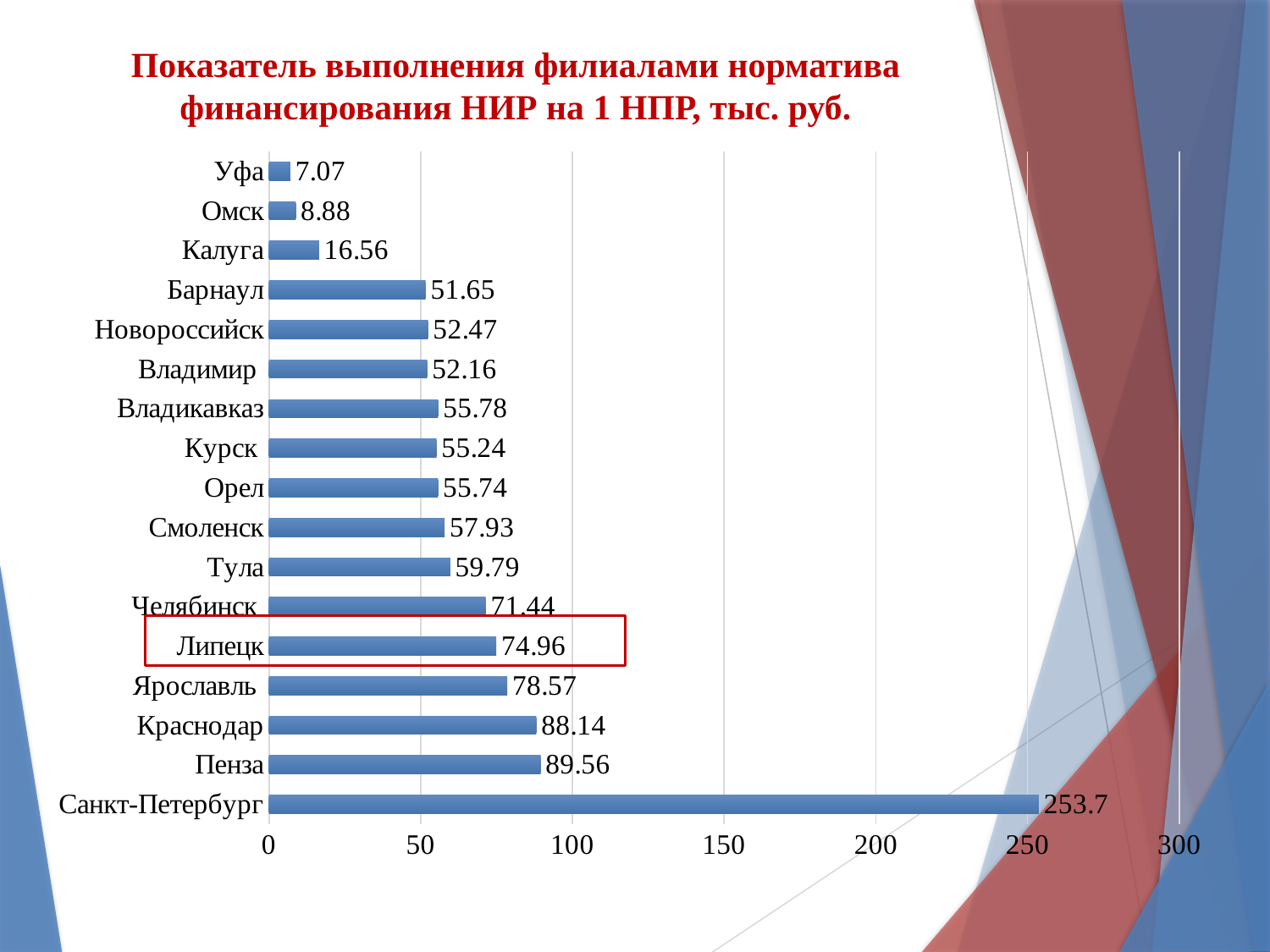
What is the value for Калуга? 16.56 Is the value for Ярославль greater or less than 100? less What kind of chart is shown on the slide? bar chart What is the difference between the values for Пенза and Краснодар? 1.42 What is the value for Липецк? 74.96 Which is larger, the value for Челябинск or the value for Тула? Челябинск Which branch is highlighted with a red box in the chart? Липецк How many branches are shown in the chart? 17 Which branch has the highest value? Санкт-Петербург Which branch has the lowest value? Уфа What is the difference between the values for Санкт-Петербург and Пенза? 164.14 What is the value for Санкт-Петербург? 253.7